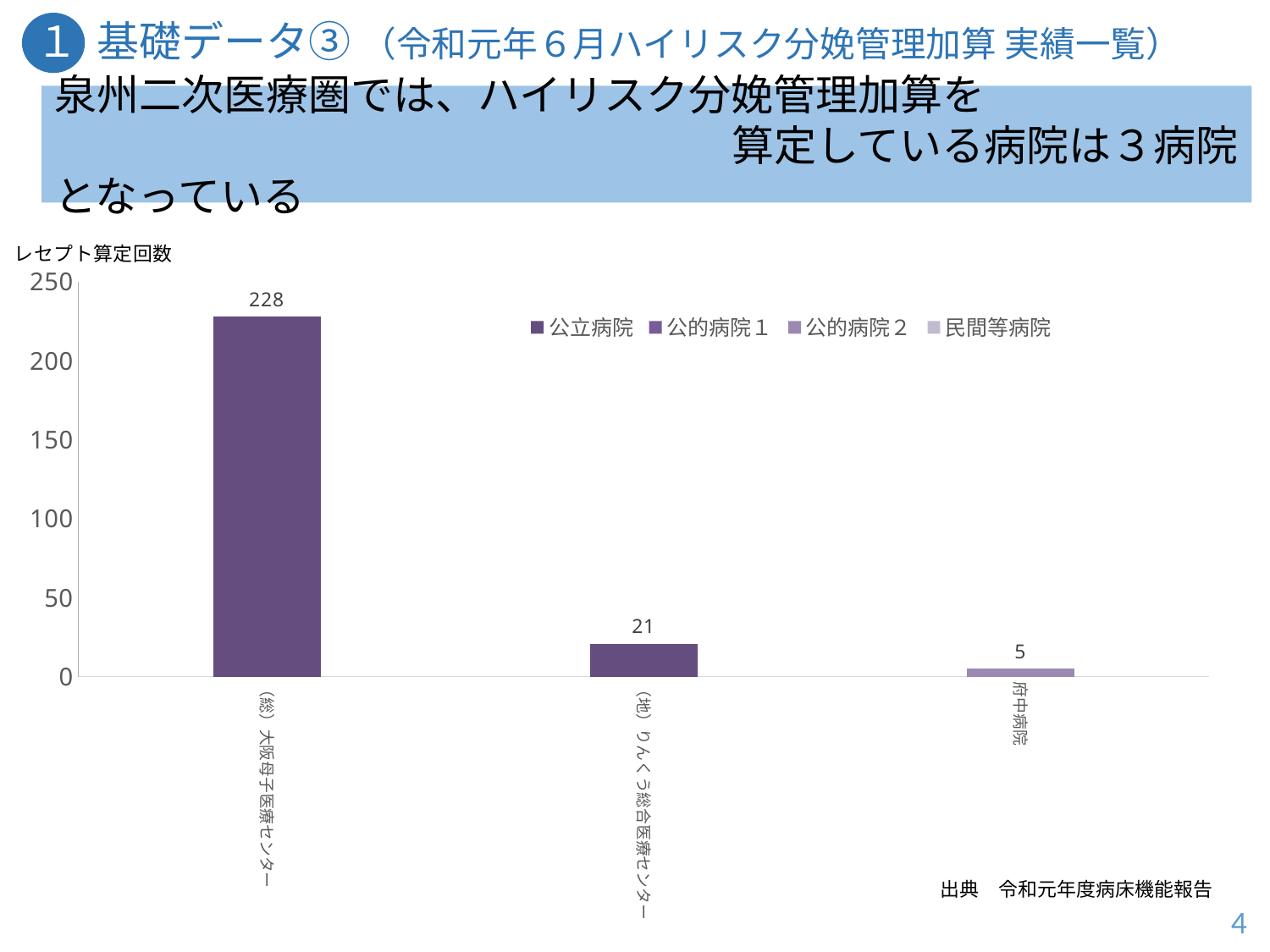
What is the value for （総）大阪母子医療センター? 228 How many hospitals are shown on the x axis? 3 Which hospital has the highest value? （総）大阪母子医療センター What is the difference between the values for （地）りんくう総合医療センター and 府中病院? 16 Is the value for （総）大阪母子医療センター greater or less than 200? greater What kind of chart is shown? bar chart Which hospital has the lowest value? 府中病院 Which is larger, the value for （地）りんくう総合医療センター or 府中病院? （地）りんくう総合医療センター What is the value for 府中病院? 5 How many series does the legend list? 4 What is the difference between the values for （総）大阪母子医療センター and （地）りんくう総合医療センター? 207 What is the value for （地）りんくう総合医療センター? 21